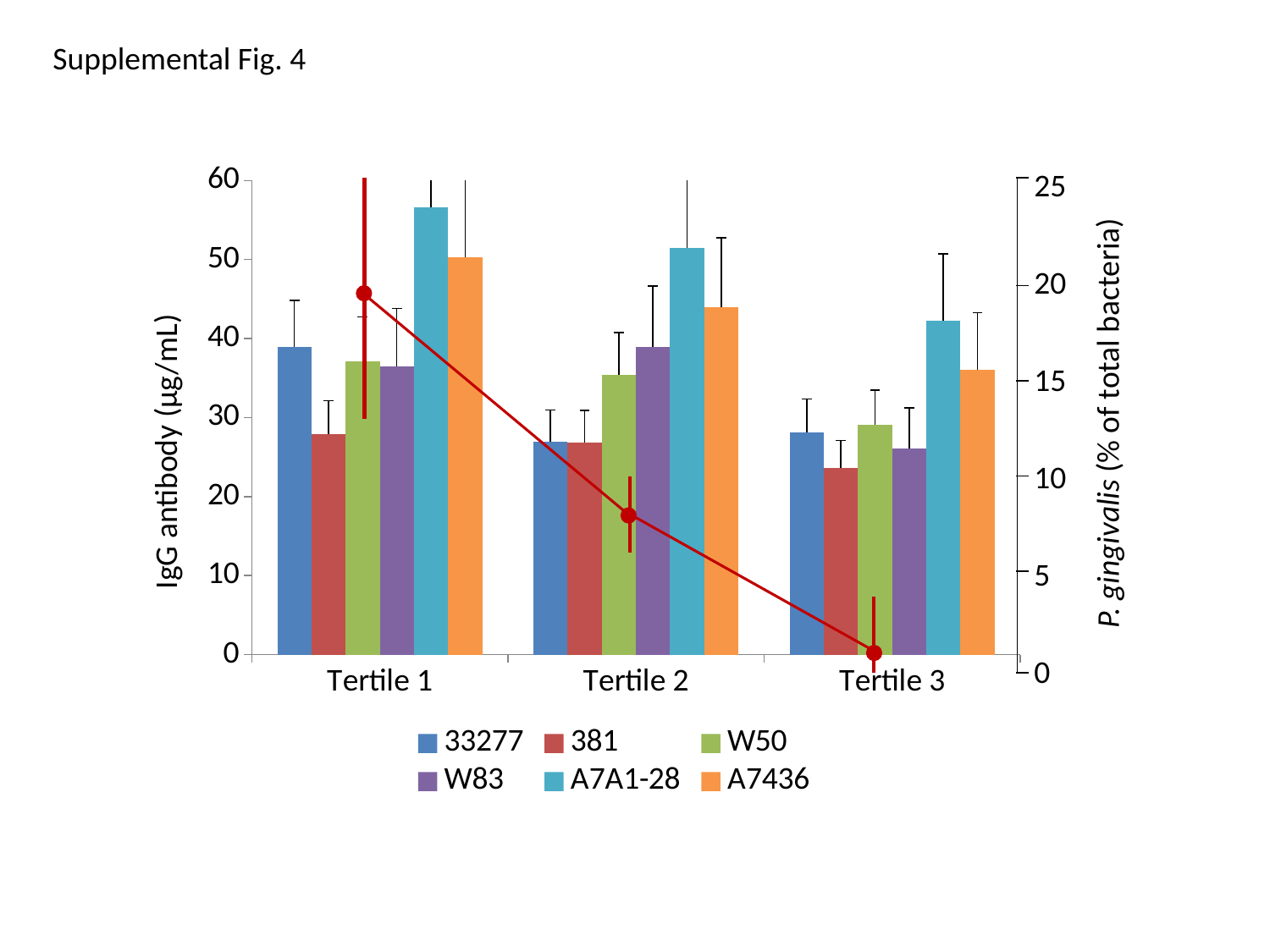
Does the red line for P. gingivalis (% of total bacteria) rise or fall from Tertile 1 to Tertile 3? Fall Which series has the highest IgG antibody value in Tertile 1? A7A1-28 Which series has the highest IgG antibody value in Tertile 2? A7A1-28 Which series has the lowest IgG antibody value in Tertile 1? 381 Is the IgG antibody value for A7A1-28 in Tertile 3 greater or less than 40? greater What kind of chart is used for the IgG antibody values? Bar chart What is the label of the left vertical axis of the chart? IgG antibody (µg/mL) Is the IgG antibody value for A7A1-28 in Tertile 1 greater or less than 50? greater How many tertile categories are shown on the x axis of the chart? 3 Is the IgG antibody value for 381 in Tertile 3 greater or less than 30? less Is the IgG antibody value for 33277 larger in Tertile 1 or in Tertile 3? Tertile 1 How many series does the chart's legend list? 6